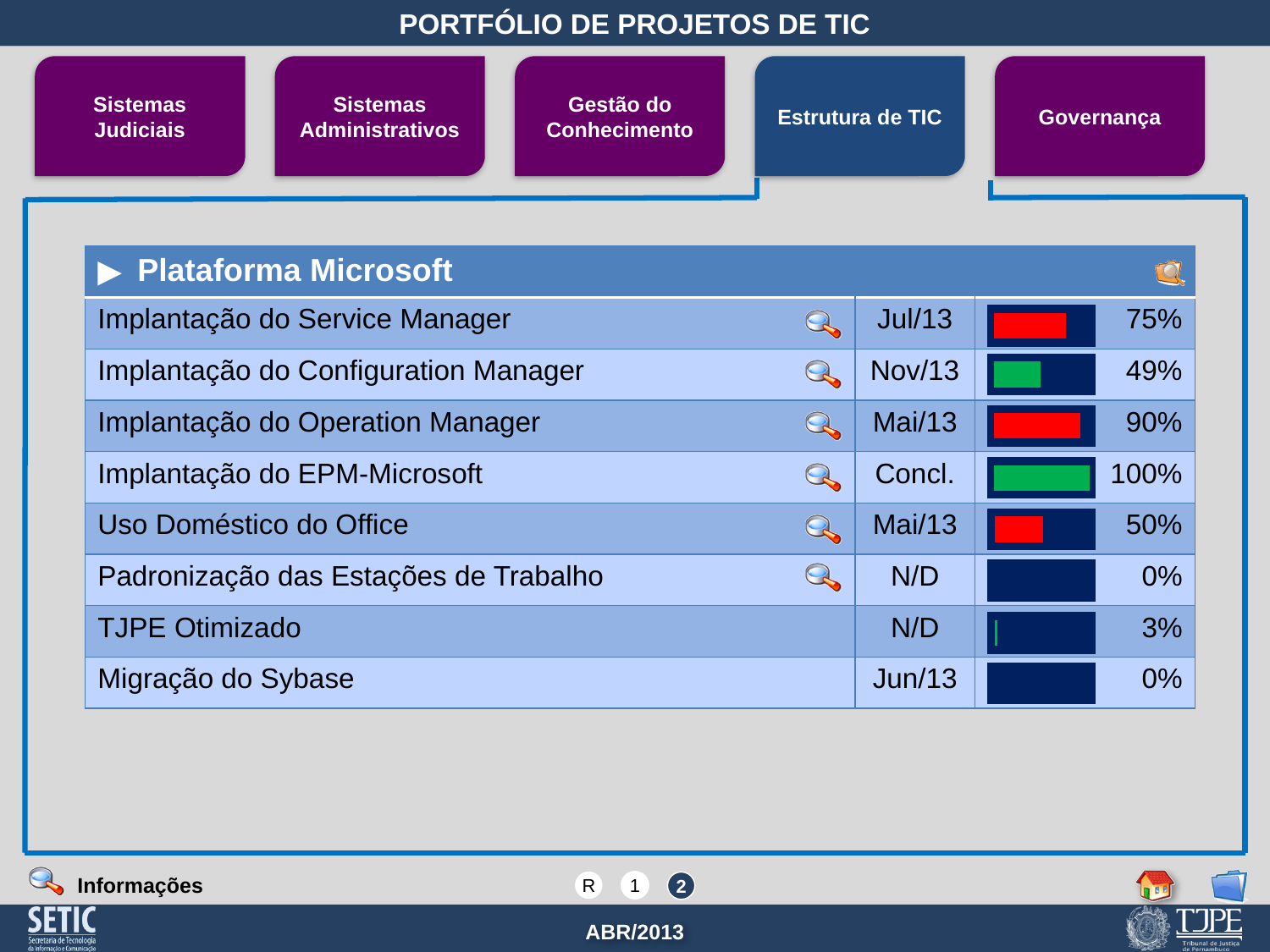
What completion percentage is shown for Uso Doméstico do Office? 50% What is the title of the table containing the progress bars? Plataforma Microsoft What is the difference in completion percentage between Implantação do Operation Manager and Implantação do Service Manager? 15% What completion percentage is shown for Implantação do Service Manager? 75% How many projects are listed under Plataforma Microsoft? 8 Which has a higher completion percentage, Implantação do Service Manager or Implantação do Configuration Manager? Implantação do Service Manager What colour is the progress bar for Implantação do Configuration Manager? Green What kind of chart is used to show the completion of each project? Bar chart How many projects show a completion of 0%? 2 Which project has the highest completion percentage? Implantação do EPM-Microsoft What completion percentage is shown for TJPE Otimizado? 3% What completion percentage is shown for Implantação do Configuration Manager? 49%